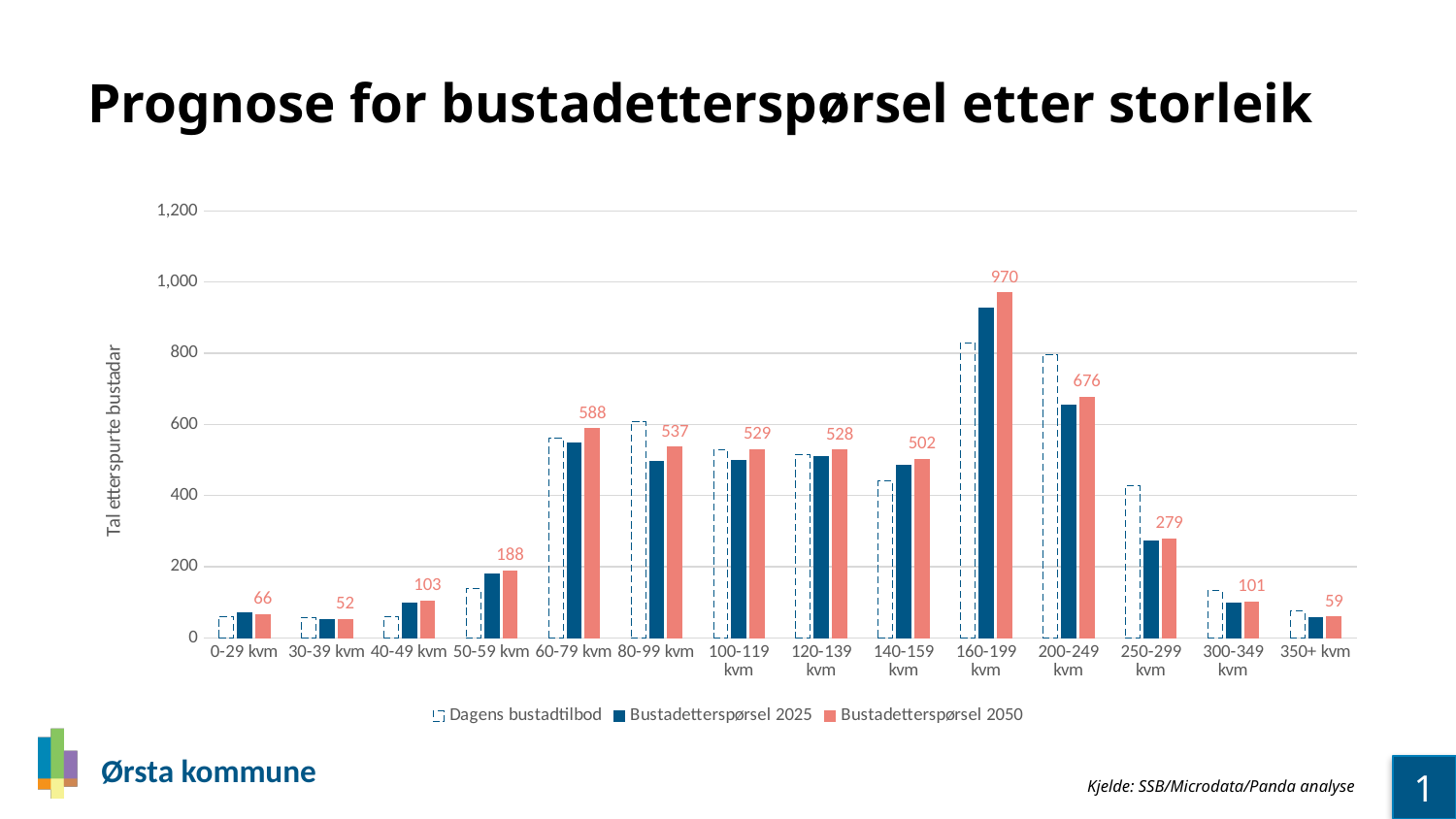
Which size category has the highest Bustadetterspørsel 2050 value? 160-199 kvm Which is larger for Bustadetterspørsel 2050: 100-119 kvm or 250-299 kvm? 100-119 kvm Is the Bustadetterspørsel 2025 value for 160-199 kvm greater or less than 800? greater What is the Bustadetterspørsel 2050 value for 160-199 kvm? 970 What is the Bustadetterspørsel 2050 value for 60-79 kvm? 588 What type of chart is shown on the slide? Bar chart What is the Bustadetterspørsel 2050 value for 350+ kvm? 59 Is the Dagens bustadtilbod value for 250-299 kvm greater or less than 600? less How many series does the legend list? 3 Which size category has the lowest Bustadetterspørsel 2050 value? 30-39 kvm What is the difference between the Bustadetterspørsel 2050 values for 160-199 kvm and 200-249 kvm? 294 How many size categories are shown on the x axis? 14